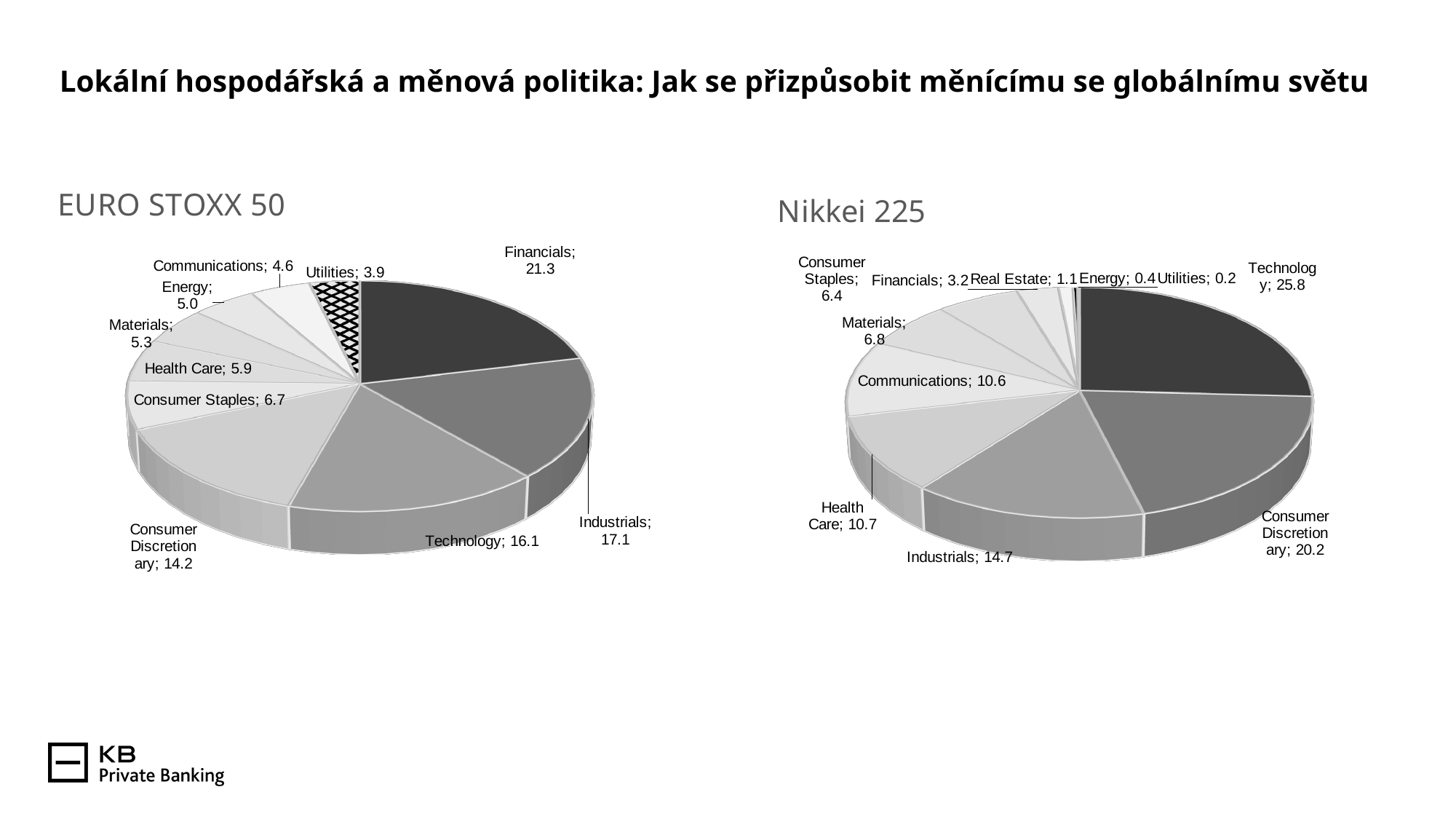
In the Nikkei 225 chart, what is the difference between Consumer Discretionary and Industrials? 5.5 What type of chart is used for EURO STOXX 50? Pie chart How many sectors are shown in the Nikkei 225 chart? 11 In the Nikkei 225 chart, what is the value for Technology? 25.8 In the EURO STOXX 50 chart, which sector has the smallest slice? Utilities In the EURO STOXX 50 chart, what is the difference between Industrials and Technology? 1.0 How many sectors are shown in the EURO STOXX 50 chart? 10 In the Nikkei 225 chart, which sector has the smallest slice? Utilities In the Nikkei 225 chart, which sector has the largest slice? Technology In the EURO STOXX 50 chart, which is larger, Consumer Staples or Health Care? Consumer Staples In the EURO STOXX 50 chart, what is the value for Financials? 21.3 Which sector appears in the Nikkei 225 chart but not in the EURO STOXX 50 chart? Real Estate